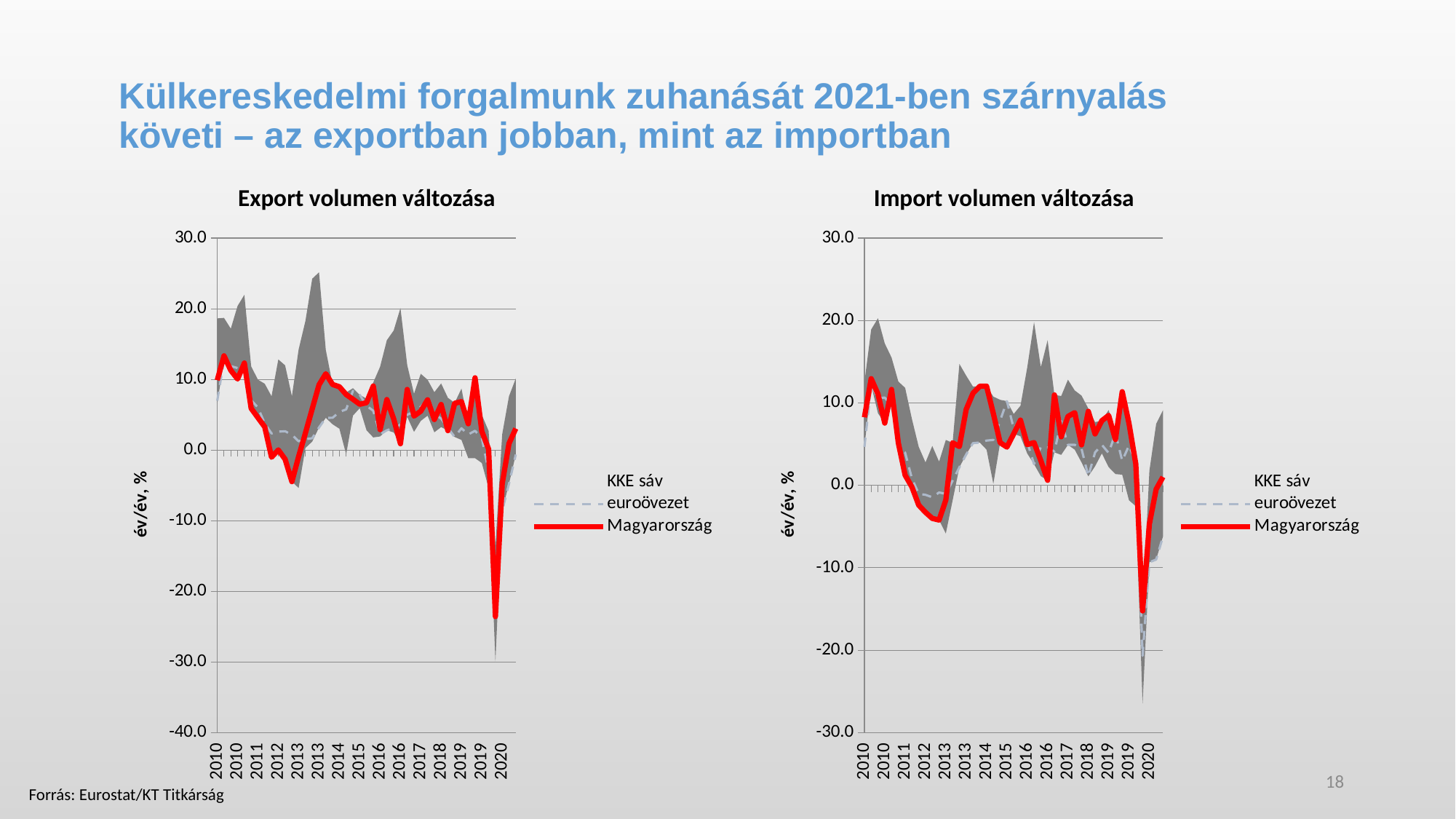
What kind of chart is the "Export volumen változása" chart? combination area and line chart In the "Import volumen változása" chart, does the Magyarország line rise or fall between the start of 2010 and 2012? fall In the "Export volumen változása" chart, is the lowest value of the Magyarország line in 2020 greater or less than -20.0? less In the "Export volumen változása" chart, is the highest value of the Magyarország line in 2010 greater or less than 10.0? greater What is the lowest y-axis tick shown on the "Import volumen változása" chart? -30.0 In the "Import volumen változása" chart, is the lowest value of the Magyarország line in 2020 greater or less than -10.0? less In the "Export volumen változása" chart, which series is drawn as a solid red line? Magyarország What is the lowest y-axis tick shown on the "Export volumen változása" chart? -40.0 In the "Export volumen változása" chart, does the Magyarország line rise or fall between the start of 2010 and the start of 2013? fall What is the y-axis label of the "Import volumen változása" chart? év/év, % How many entries does the legend of the "Import volumen változása" chart list? 3